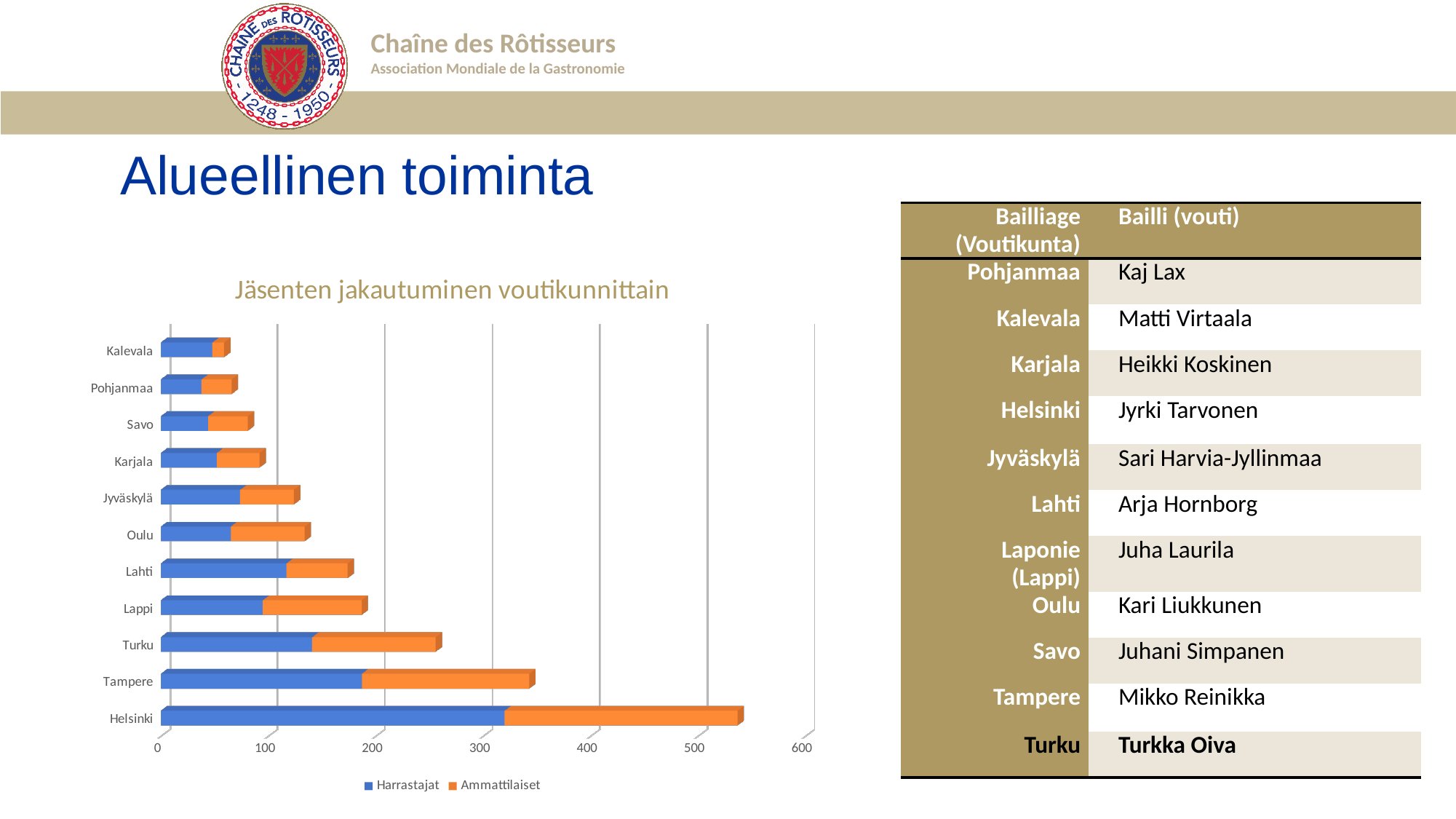
Which has the larger total bar, Tampere or Turku? Tampere Which series is shown in orange in the chart? Ammattilaiset Is the total bar for Helsinki greater or less than 500? greater Is the total bar for Tampere greater or less than 300? greater Is the Harrastajat value for Helsinki greater or less than 300? greater How many categories (voutikunnat) are shown in the chart? 11 What is the title of the chart? Jäsenten jakautuminen voutikunnittain How many series does the chart legend list? 2 Which category has the longest total bar in the chart? Helsinki What kind of chart is shown on the slide? bar chart